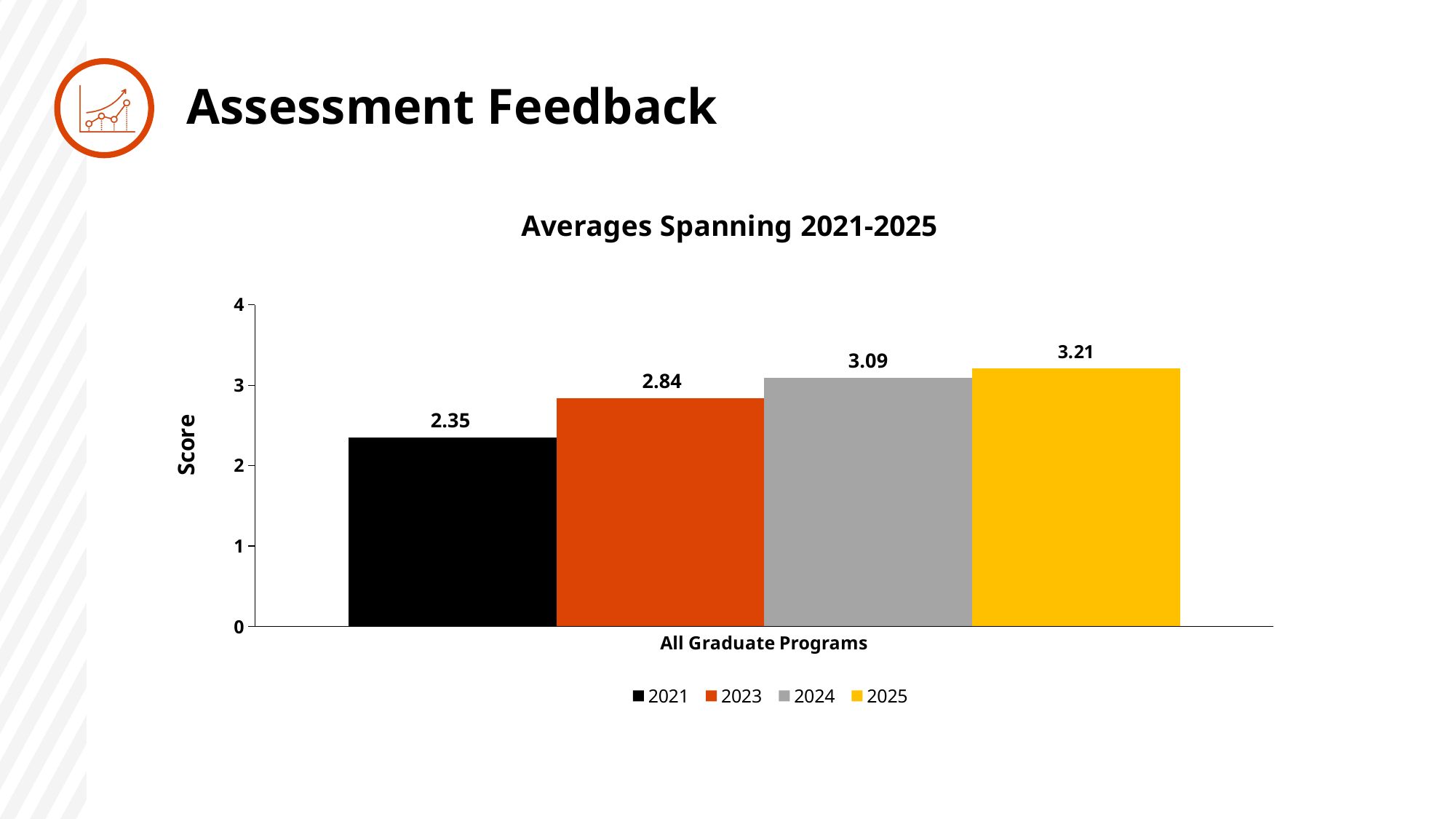
Which year has the highest score? 2025 How many series does the legend list? 4 Which year has the lowest score? 2021 What is the score for 2024? 3.09 What is the score for 2021? 2.35 Which is larger, the score for 2023 or the score for 2024? 2024 What is the difference between the 2025 score and the 2021 score? 0.86 What is the score for 2023? 2.84 What is the title of the chart? Averages Spanning 2021-2025 What is the score for 2025? 3.21 What kind of chart is shown? bar chart Is the score for 2021 greater or less than 3? less